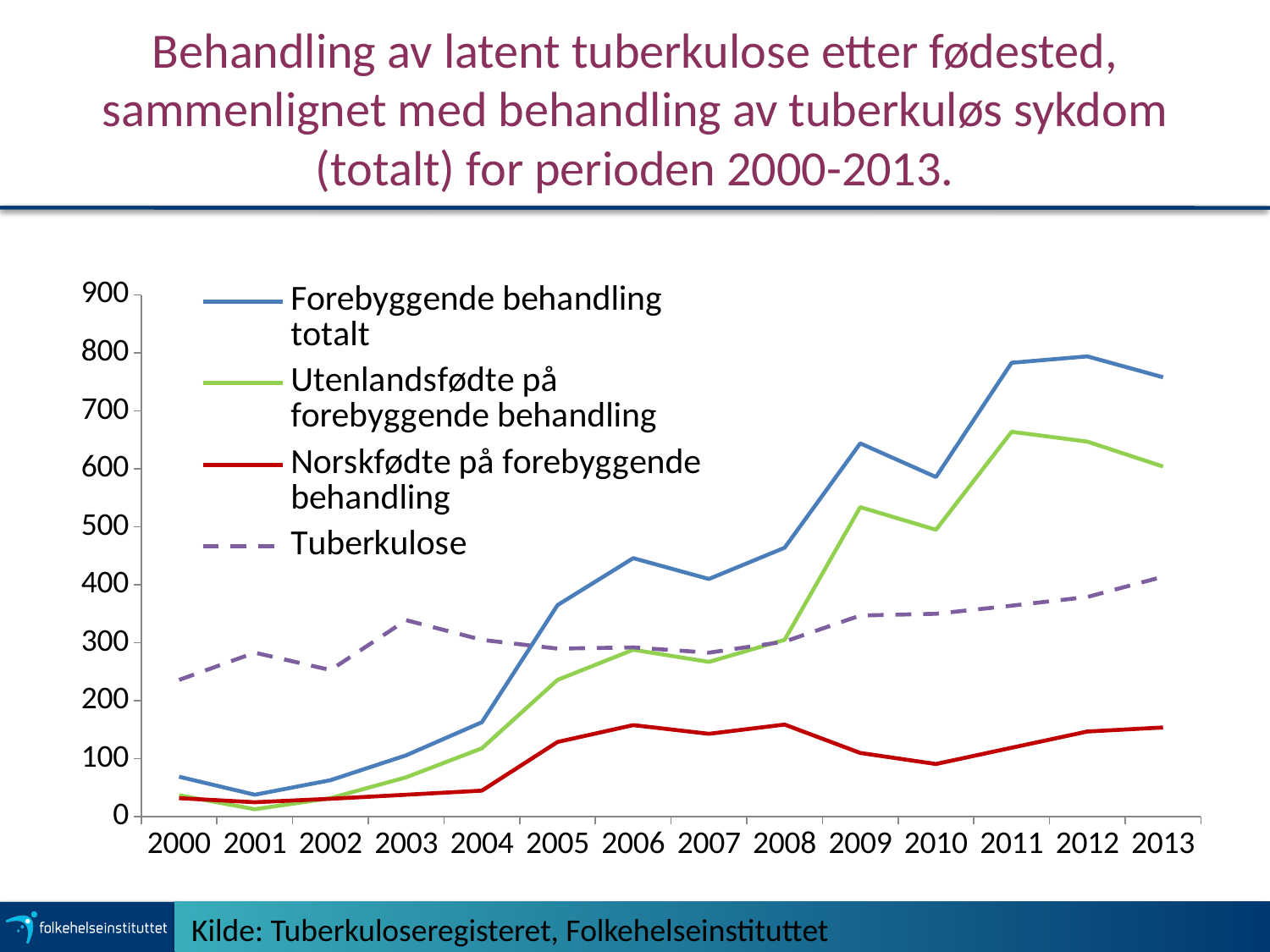
What kind of chart is shown on the slide? line chart Is the value for Forebyggende behandling totalt in 2012 greater or less than 700? greater Which series has the highest value in 2013? Forebyggende behandling totalt How many years are shown on the x axis? 14 In 2003, which is larger: Tuberkulose or Forebyggende behandling totalt? Tuberkulose Is the value for Norskfødte på forebyggende behandling in 2013 greater or less than 200? less Is the value for Tuberkulose in 2000 greater or less than 300? less Does Forebyggende behandling totalt generally rise or fall from 2000 to 2013? rise Which series is drawn with a dashed line? Tuberkulose How many series does the legend list? 4 Which series has the lowest value in 2013? Norskfødte på forebyggende behandling